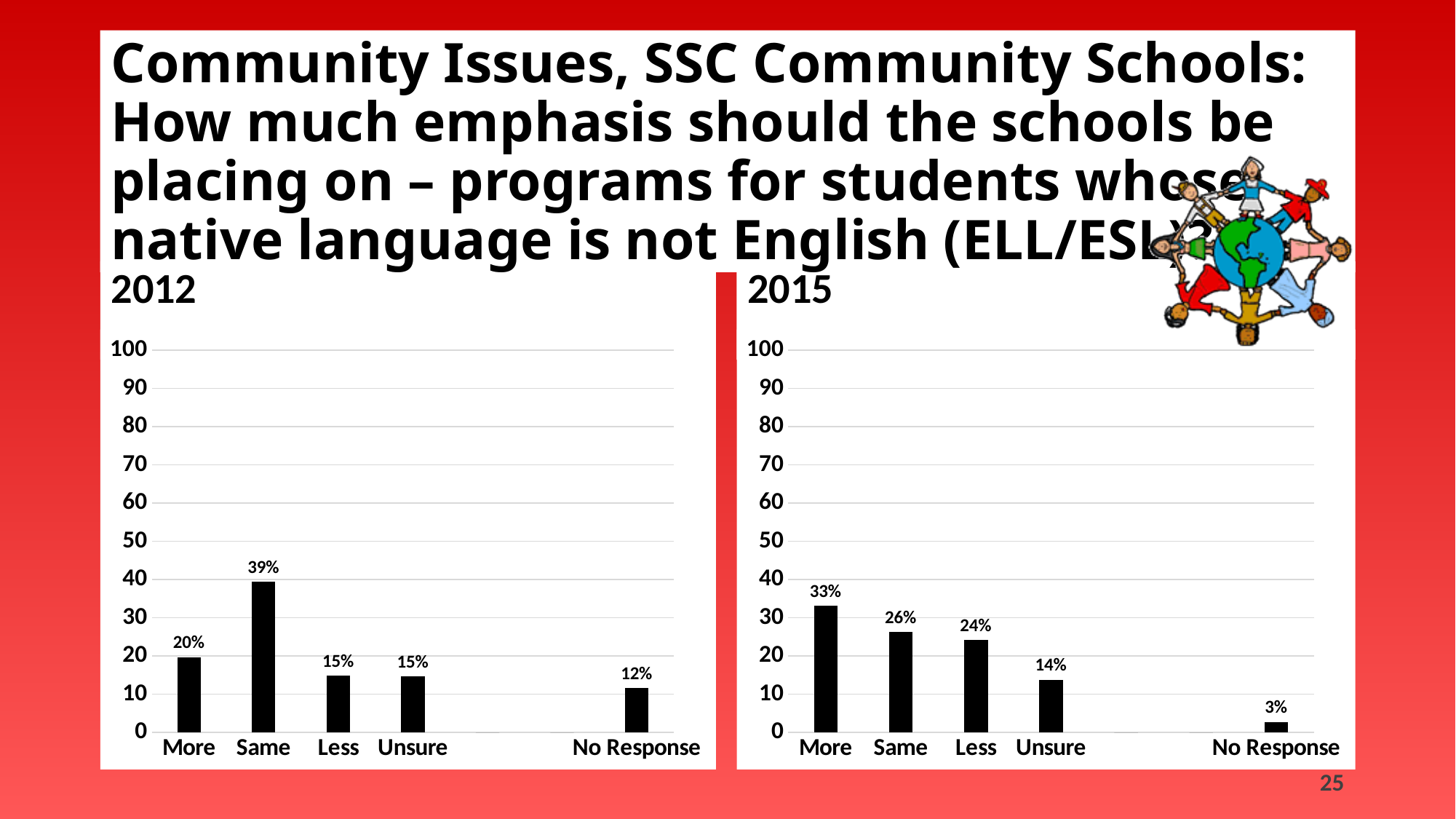
In the 2012 chart, what is the difference between Same and More? 19% In the 2015 chart, what is the value for More? 33% In the 2015 chart, do the values rise or fall from More to No Response? fall In the 2015 chart, which category has the lowest value? No Response How many categories are shown on the x axis of the 2012 chart? 5 In the 2015 chart, what is the value for No Response? 3% In the 2012 chart, what is the value for Same? 39% In the 2015 chart, which is larger, Same or Less? Same In the 2012 chart, which category has the highest value? Same What type of chart is the 2015 chart? bar chart In the 2015 chart, what is the difference between More and Unsure? 19% In the 2012 chart, is the value for Same greater or less than 30? greater